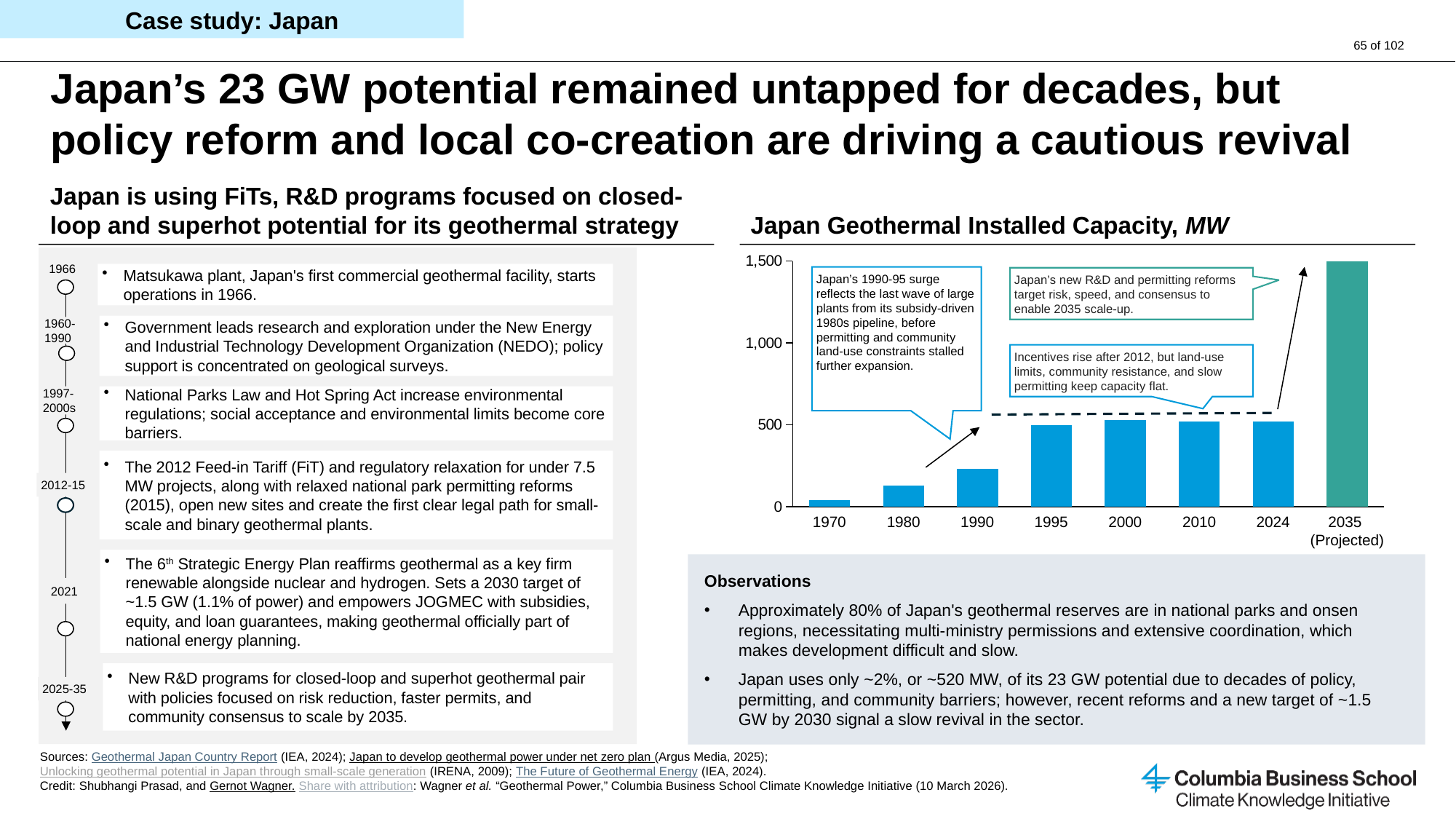
What unit is given in the title of the Japan Geothermal Installed Capacity chart? MW Do the installed capacity values generally rise or fall from 1970 to 2035 along the x axis? rise Which year has the lowest installed capacity in the Japan Geothermal Installed Capacity chart? 1970 Is the installed capacity for 1980 greater or less than 500 MW? less Which has the larger installed capacity, 2024 or 2035 (Projected)? 2035 (Projected) What kind of chart is shown under the title 'Japan Geothermal Installed Capacity, MW'? bar chart How many years (categories) are plotted on the x axis of the Japan Geothermal Installed Capacity chart? 8 Which year has the highest installed capacity in the Japan Geothermal Installed Capacity chart? 2035 (Projected) Is the installed capacity for 1970 greater or less than 500 MW? less Is the installed capacity for 1990 greater or less than 500 MW? less Which year has the larger installed capacity, 1980 or 1990? 1990